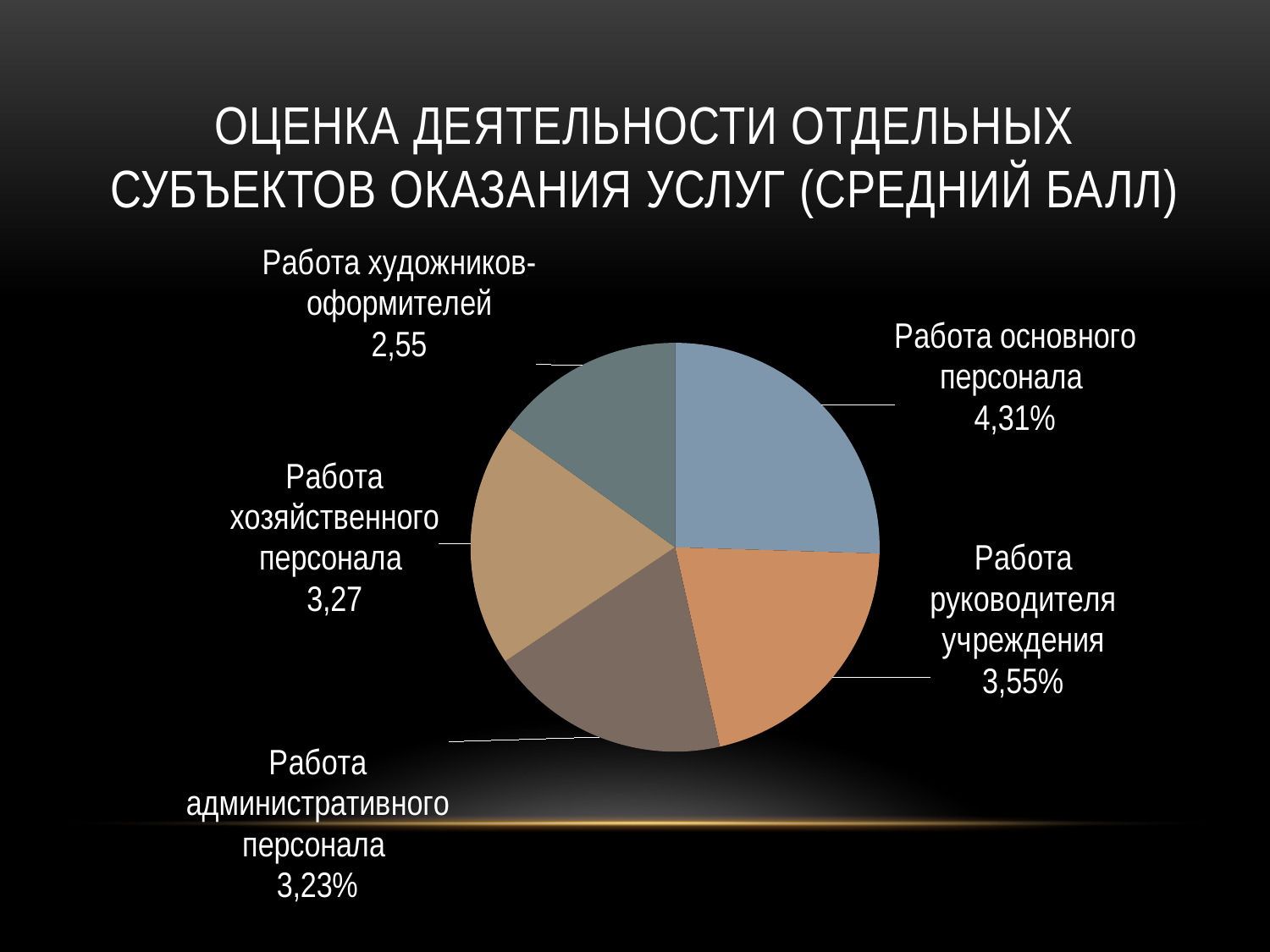
Which is larger: the value for "Работа руководителя учреждения" or for "Работа художников-оформителей"? Работа руководителя учреждения What is the value shown for "Работа основного персонала"? 4,31% How many slices does the pie chart have? 5 What is the value shown for "Работа административного персонала"? 3,23% What is the value shown for "Работа хозяйственного персонала"? 3,27 What type of chart is shown on the slide? Pie chart What is the value shown for "Работа руководителя учреждения"? 3,55% Which category has the highest value in the pie chart? Работа основного персонала What is the title of the chart on the slide? Оценка деятельности отдельных субъектов оказания услуг (средний балл) Which category has the lowest value in the pie chart? Работа художников-оформителей What is the value shown for "Работа художников-оформителей"? 2,55 What is the difference between the values for "Работа основного персонала" and "Работа руководителя учреждения"? 0,76%